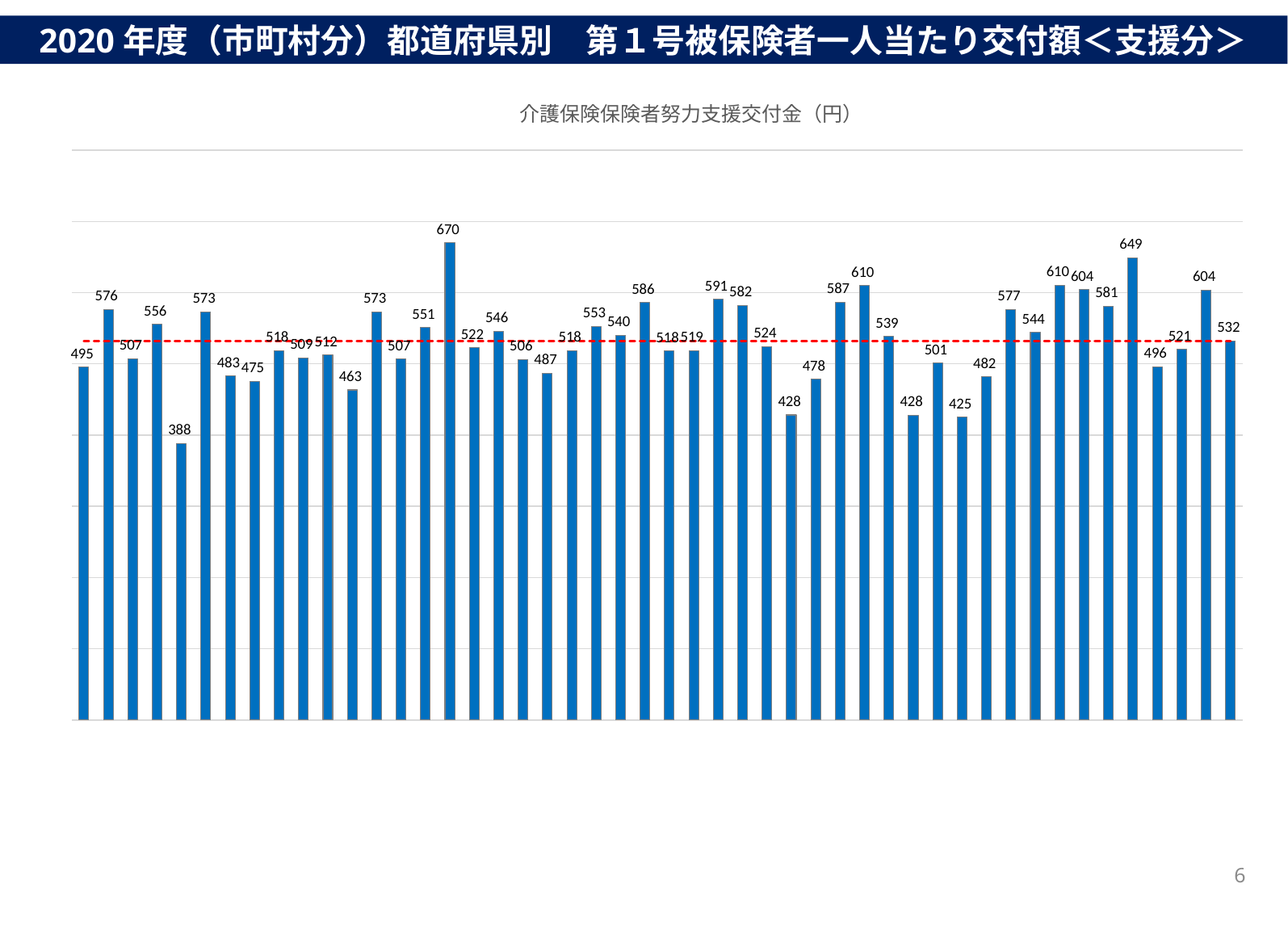
How many bars are plotted in the chart? 48 What is the second-highest value labelled on a bar in the chart? 649 What is the value labelled on the leftmost bar of the chart? 495 What kind of chart is shown on the slide? bar chart What is the lowest value labelled on any bar in the chart? 388 What colour is the horizontal dashed reference line drawn across the chart? red What is the value labelled on the rightmost bar of the chart? 532 What is the highest value labelled on any bar in the chart? 670 What is the difference between the highest bar value (670) and the lowest bar value (388)? 282 Which is larger, the leftmost bar (495) or the rightmost bar (532)? the rightmost bar (532) What is the title printed above the chart? 介護保険保険者努力支援交付金（円） What is the difference between the two highest bar values, 670 and 649? 21